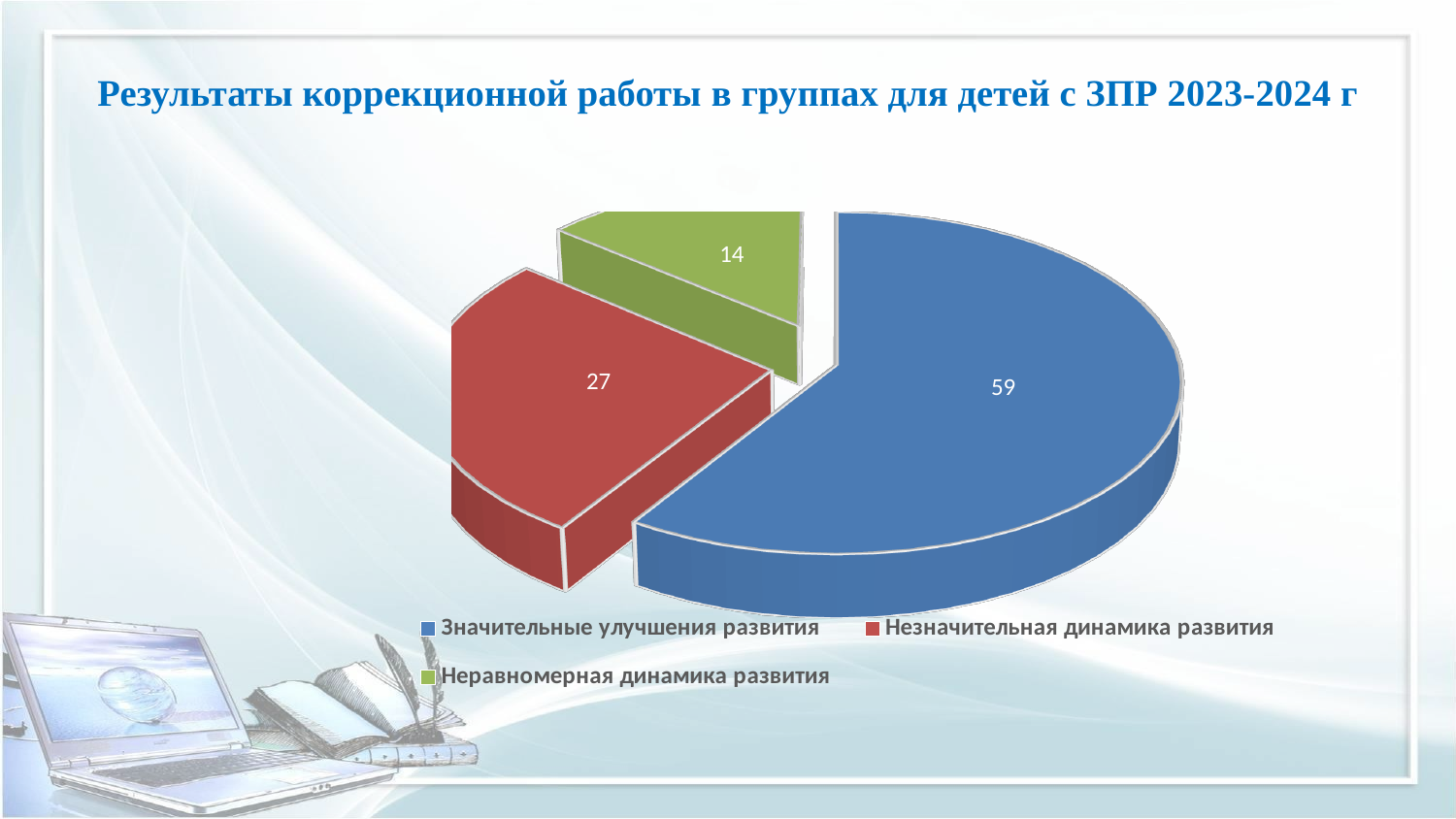
What is the value for "Значительные улучшения развития"? 59 What share of the pie does "Значительные улучшения развития" represent? 59% Which is larger: the value for "Незначительная динамика развития" or for "Неравномерная динамика развития"? Незначительная динамика развития What is the value for "Незначительная динамика развития"? 27 What is the difference between the values for "Незначительная динамика развития" and "Неравномерная динамика развития"? 13 How many slices does the pie chart have? 3 What colour is the slice for "Незначительная динамика развития"? Red What is the difference between the values for "Значительные улучшения развития" and "Незначительная динамика развития"? 32 Which category has the smallest slice of the pie? Неравномерная динамика развития What is the value for "Неравномерная динамика развития"? 14 What kind of chart is shown on the slide? Pie chart Which category has the largest slice of the pie? Значительные улучшения развития